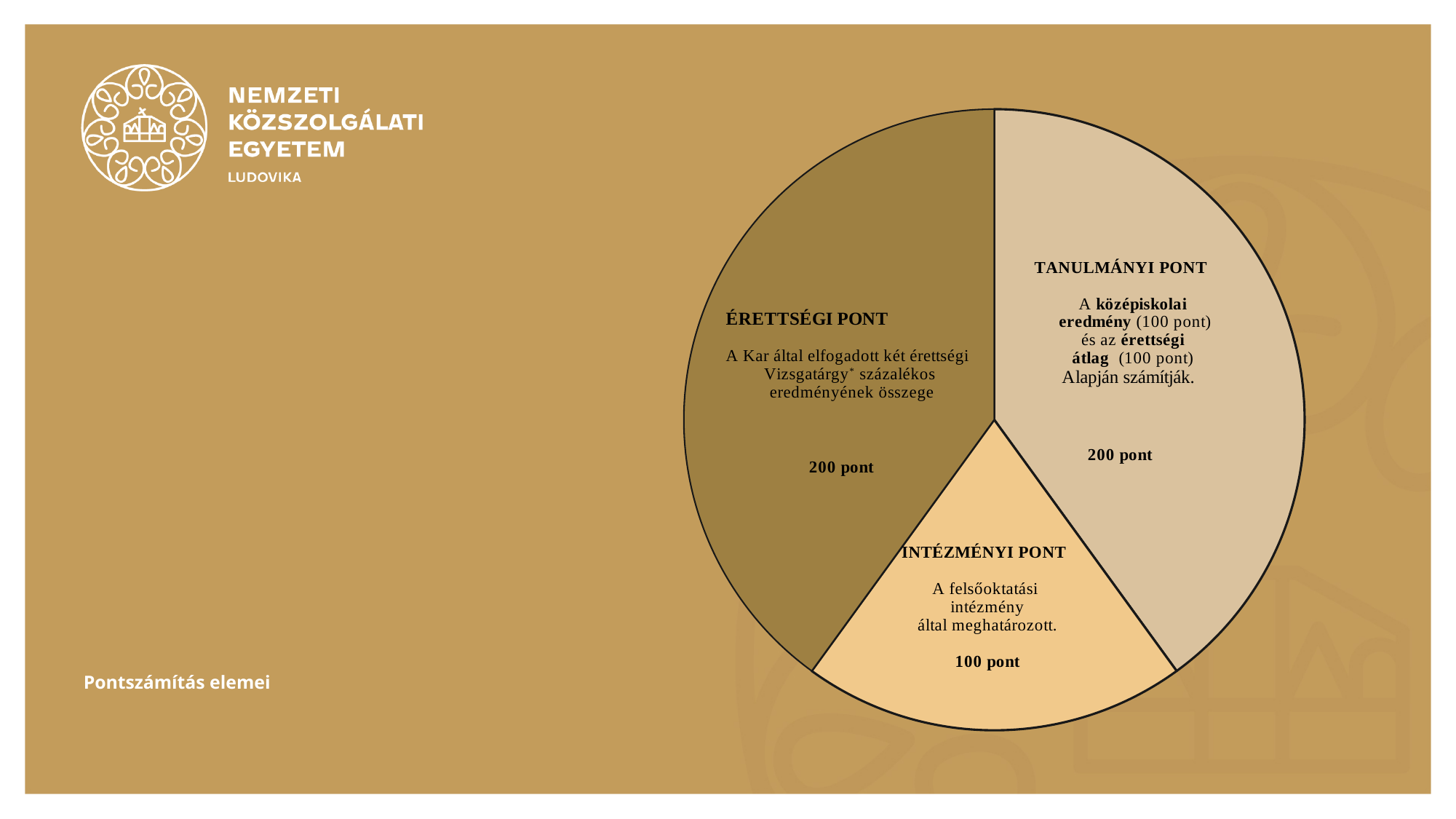
How many points is the Intézményi pont slice worth? 100 pont What is the difference in points between the Tanulmányi pont slice and the Intézményi pont slice? 100 pont What is the total number of points across all three slices of the pie chart? 500 pont How many slices does the pie chart have? 3 Which slice of the pie chart has the smallest value? Intézményi pont Which is larger, the Érettségi pont slice or the Intézményi pont slice? Érettségi pont What is the caption text in the bottom-left corner of the slide describing the chart? Pontszámítás elemei What kind of chart is shown on the slide? pie chart What share of the total points does the Tanulmányi pont slice represent? 40% What share of the total points does the Intézményi pont slice represent? 20% How many points is the Tanulmányi pont slice worth? 200 pont How many points is the Érettségi pont slice worth? 200 pont